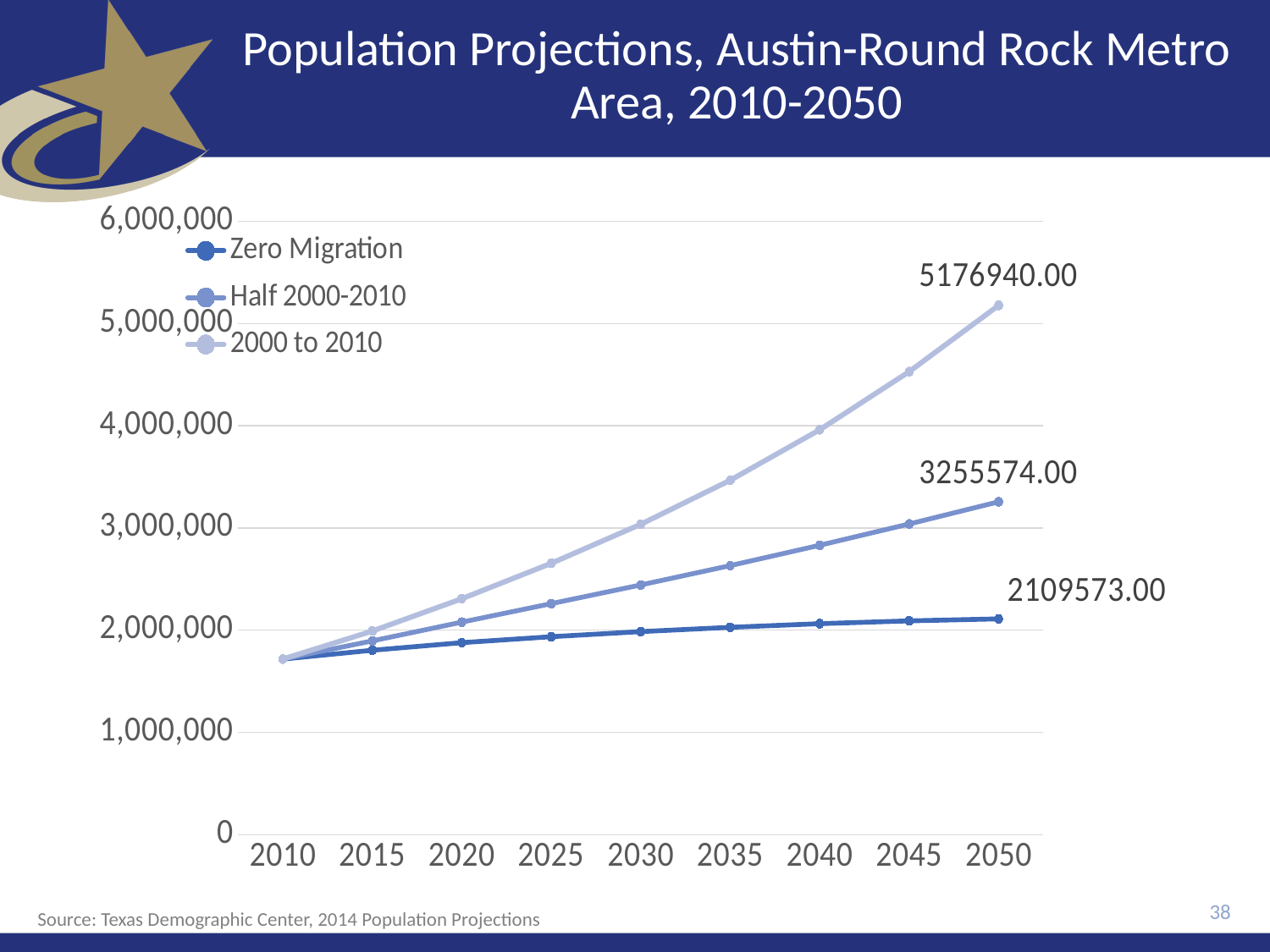
Which is larger in 2050, the Half 2000-2010 projection or the Zero Migration projection? Half 2000-2010 What type of chart is shown on the slide? line chart How many series does the legend list? 3 What is the projected population for the Zero Migration scenario in 2050? 2109573.00 Does the Zero Migration series rise or fall from 2010 to 2050? rise What is the difference between the 2000 to 2010 and Zero Migration projections in 2050? 3067367.00 Which scenario has the lowest projected population in 2050? Zero Migration What is the projected population for the Half 2000-2010 scenario in 2050? 3255574.00 How many years are shown on the x axis? 9 Which scenario has the highest projected population in 2050? 2000 to 2010 What is the projected population for the 2000 to 2010 scenario in 2050? 5176940.00